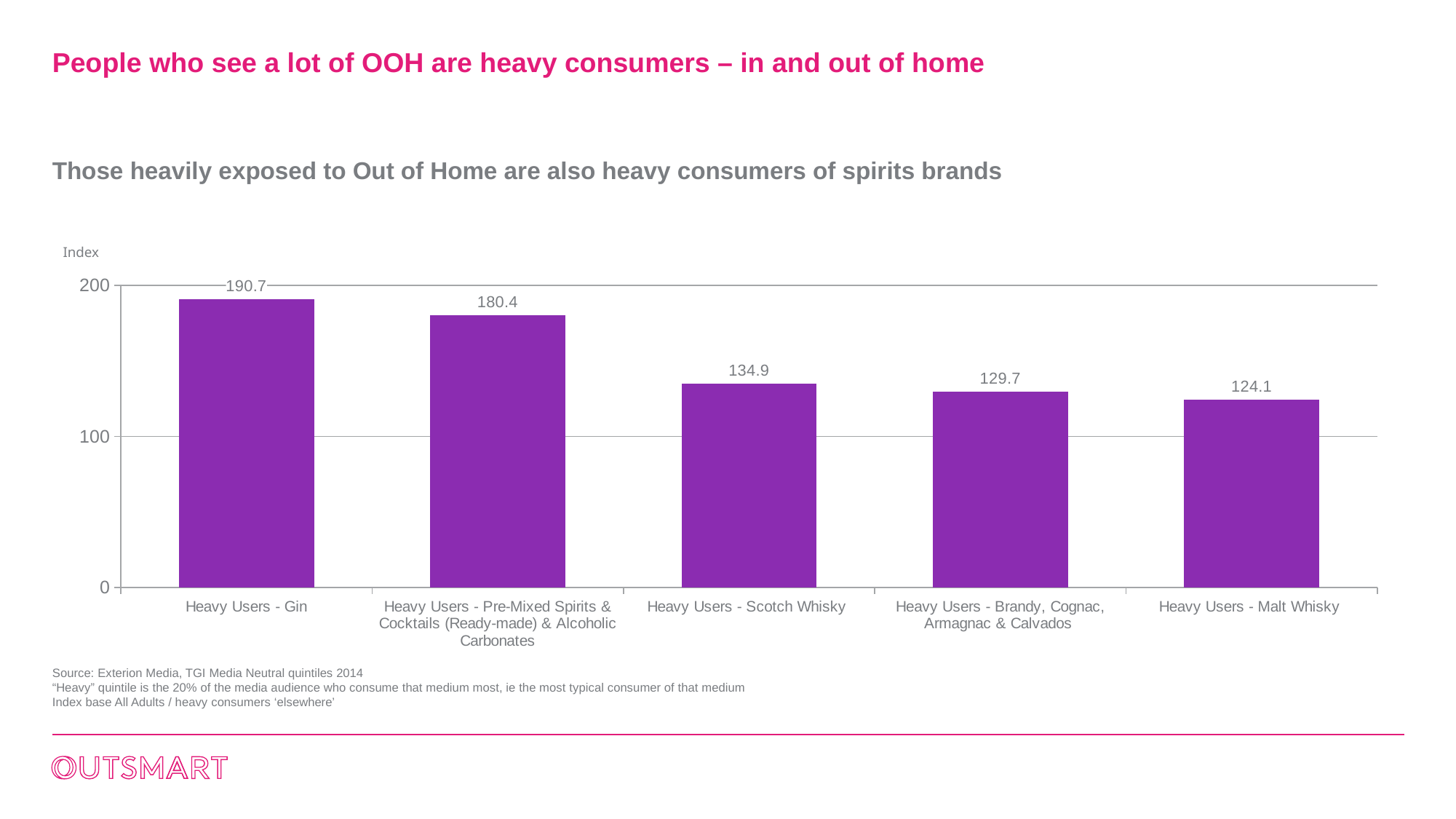
Do the values rise or fall from left to right across the categories? Fall Which category has the lowest index value? Heavy Users - Malt Whisky What is the index value for Heavy Users - Malt Whisky? 124.1 What is the index value for Heavy Users - Gin? 190.7 What is the difference between the index values for Heavy Users - Gin and Heavy Users - Malt Whisky? 66.6 What kind of chart is shown on the slide? Bar chart Which is larger, the index for Heavy Users - Scotch Whisky or for Heavy Users - Brandy, Cognac, Armagnac & Calvados? Heavy Users - Scotch Whisky How many categories are shown in the chart? 5 What is the index value for Heavy Users - Brandy, Cognac, Armagnac & Calvados? 129.7 What is the index value for Heavy Users - Scotch Whisky? 134.9 Is the value for Heavy Users - Pre-Mixed Spirits & Cocktails (Ready-made) & Alcoholic Carbonates greater or less than 100? greater Which category has the highest index value? Heavy Users - Gin